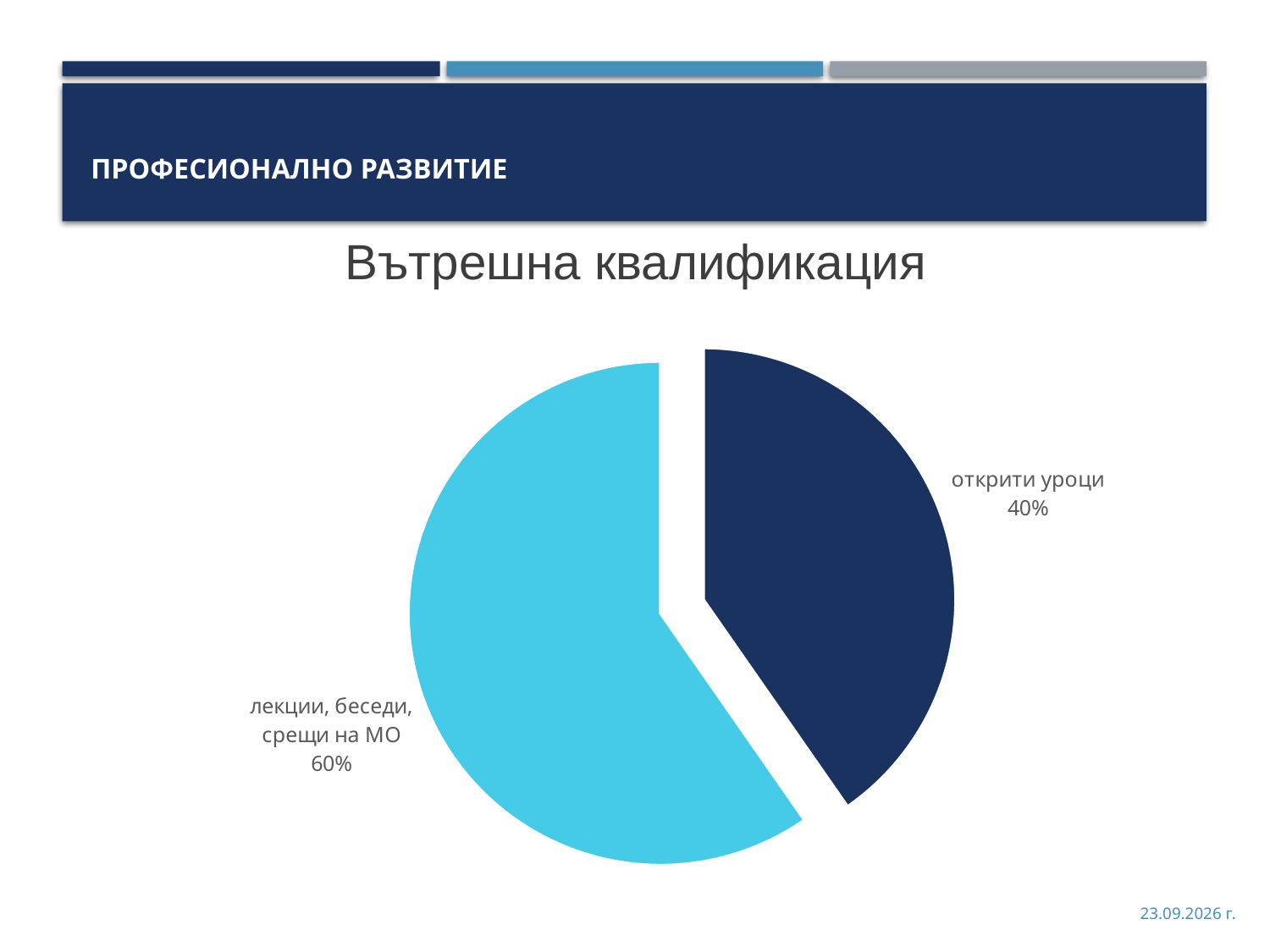
What share of the pie does "открити уроци" have? 40% What share of the pie does "лекции, беседи, срещи на МО" have? 60% What kind of chart is shown on the slide? pie chart Which is larger: the share for "открити уроци" or the share for "лекции, беседи, срещи на МО"? лекции, беседи, срещи на МО What colour is the slice for "открити уроци"? dark blue What is the title of the chart? Вътрешна квалификация Is the share for "открити уроци" greater or less than 50%? less What is the difference in percentage points between "лекции, беседи, срещи на МО" and "открити уроци"? 20% Which slice of the pie is the smallest? открити уроци How many slices does the pie chart have? 2 Which slice of the pie is the largest? лекции, беседи, срещи на МО